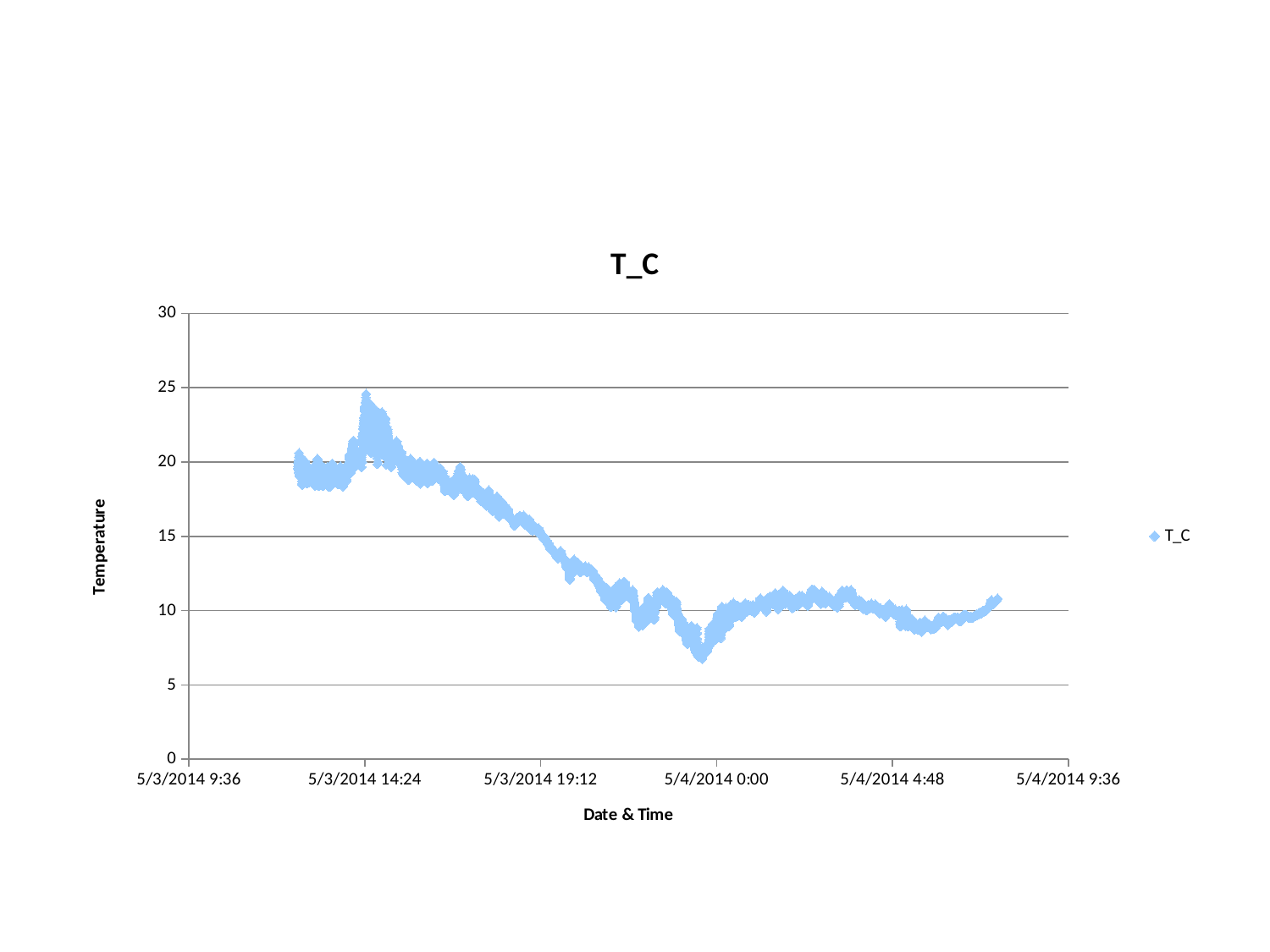
What is the label on the vertical axis of the chart? Temperature What kind of chart is shown on the slide? scatter chart Near which x-axis tick does the temperature reach its highest value? 5/3/2014 14:24 What is the title of the chart? T_C Is the highest temperature value plotted greater or less than 20? greater Is the temperature value at 5/3/2014 19:12 greater or less than 10? greater Overall, do the temperature values rise or fall from the start of the series to the end? fall How many series does the legend list? 1 Near which x-axis tick does the temperature reach its lowest value? 5/4/2014 0:00 Is the temperature value at 5/4/2014 0:00 greater or less than 10? less